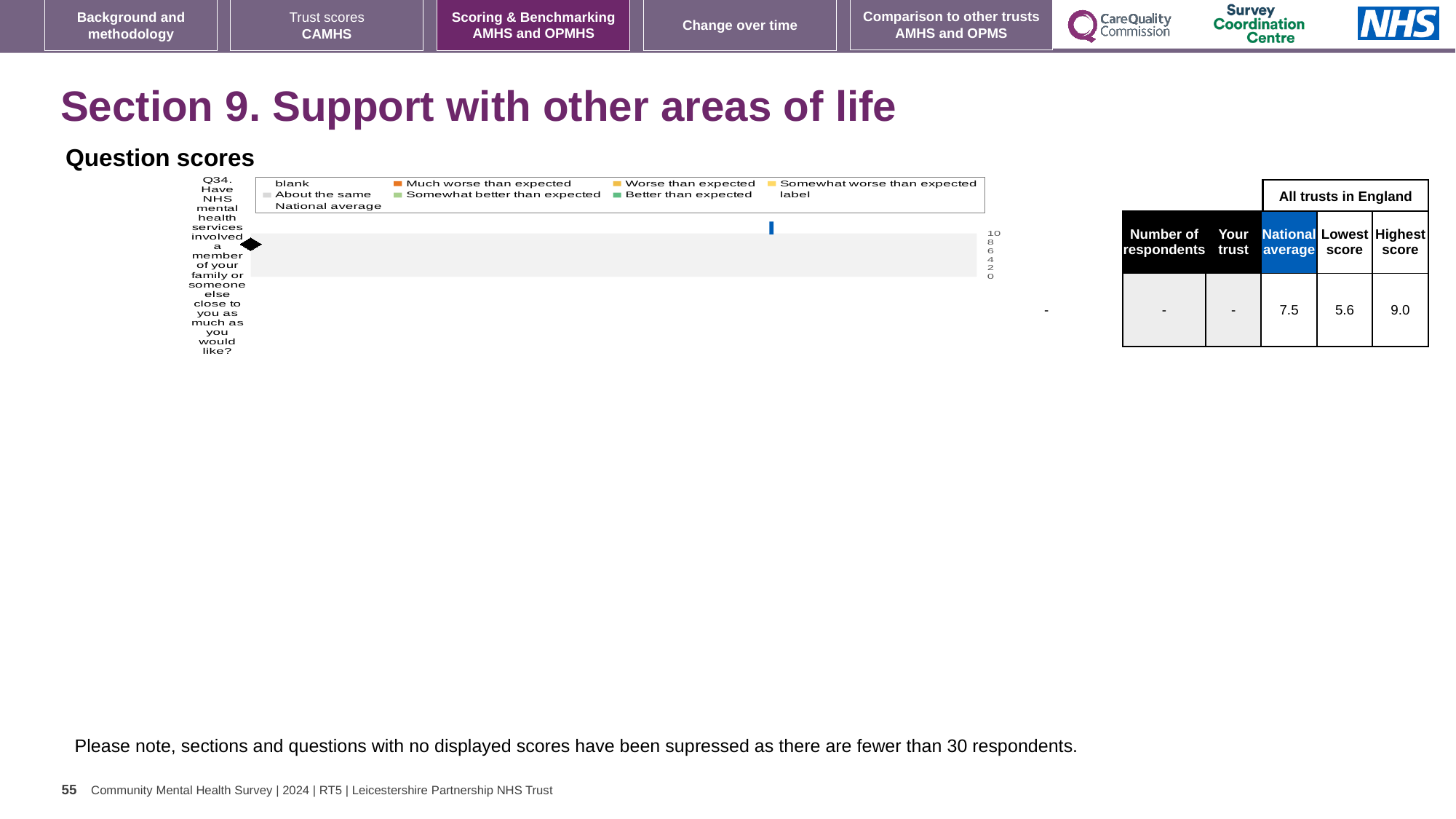
How many question categories are plotted on the chart? 1 In the table next to the chart, what is the difference between the Highest score and the Lowest score? 3.4 In the table next to the chart, is the National average greater or less than the Lowest score? greater What is the highest tick value shown on the chart's value axis? 10 In the table next to the chart, what is the Lowest score among all trusts in England? 5.6 In the table next to the chart, what is the Highest score among all trusts in England? 9.0 What kind of chart is shown under 'Question scores'? bar chart In the table next to the chart, what is shown for 'Your trust'? - Which question number is the category label on the chart? Q34 In the table next to the chart, what is the National average score for Q34? 7.5